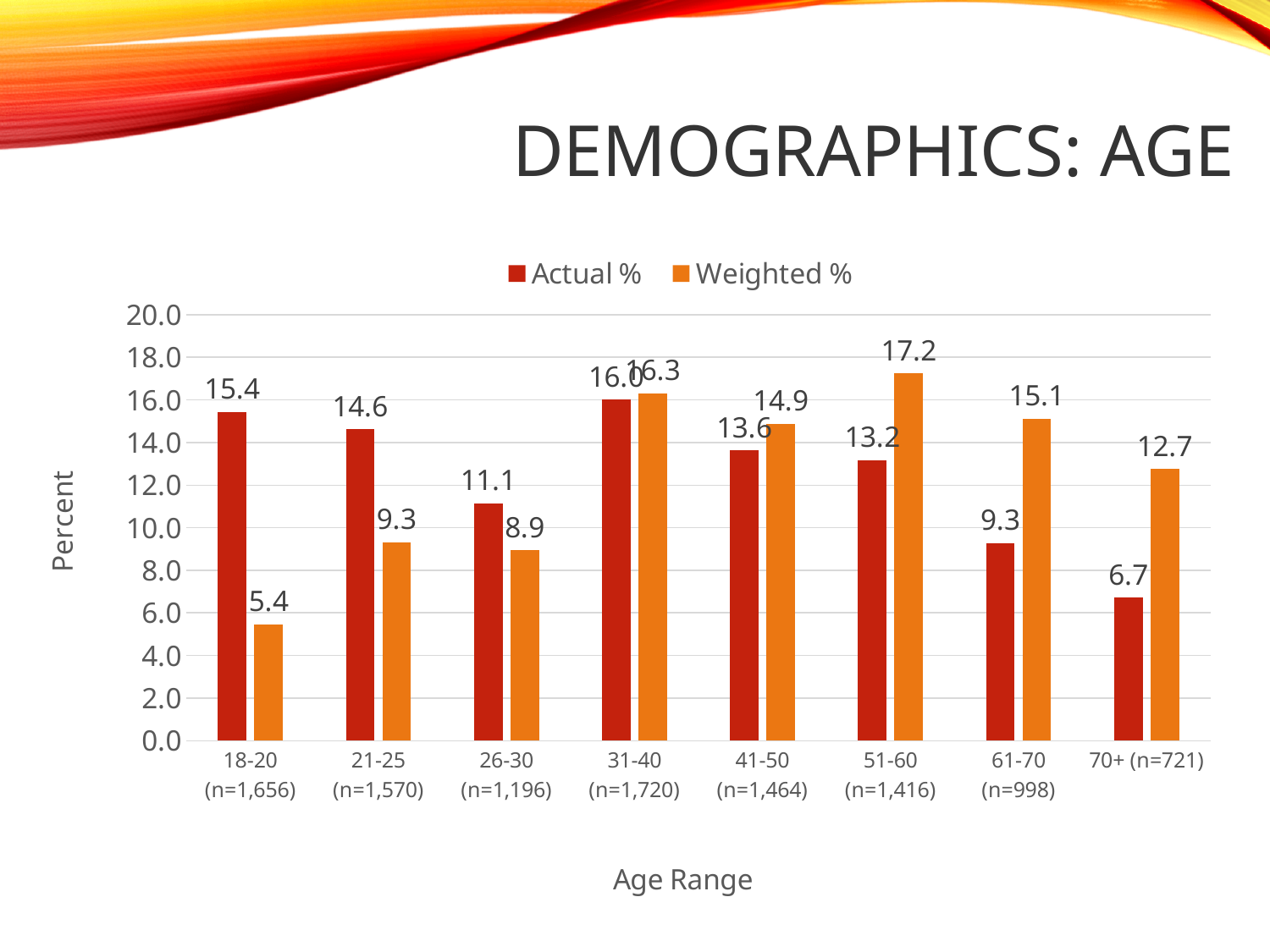
What is the Weighted % value for the 51-60 age range? 17.2 Is the Weighted % value for the 31-40 age range greater or less than 14.0? greater What is the Actual % value for the 18-20 age range? 15.4 What kind of chart is shown on the slide? bar chart How many series does the legend list? 2 For the 61-70 age range, which is larger: Actual % or Weighted %? Weighted % How many age range categories are shown on the x axis? 8 What is the Weighted % value for the 18-20 age range? 5.4 What is the difference between the Actual % and Weighted % values for the 18-20 age range? 10.0 Which age range has the highest Weighted % value? 51-60 Which age range has the lowest Actual % value? 70+ What is the Actual % value for the 70+ age range? 6.7